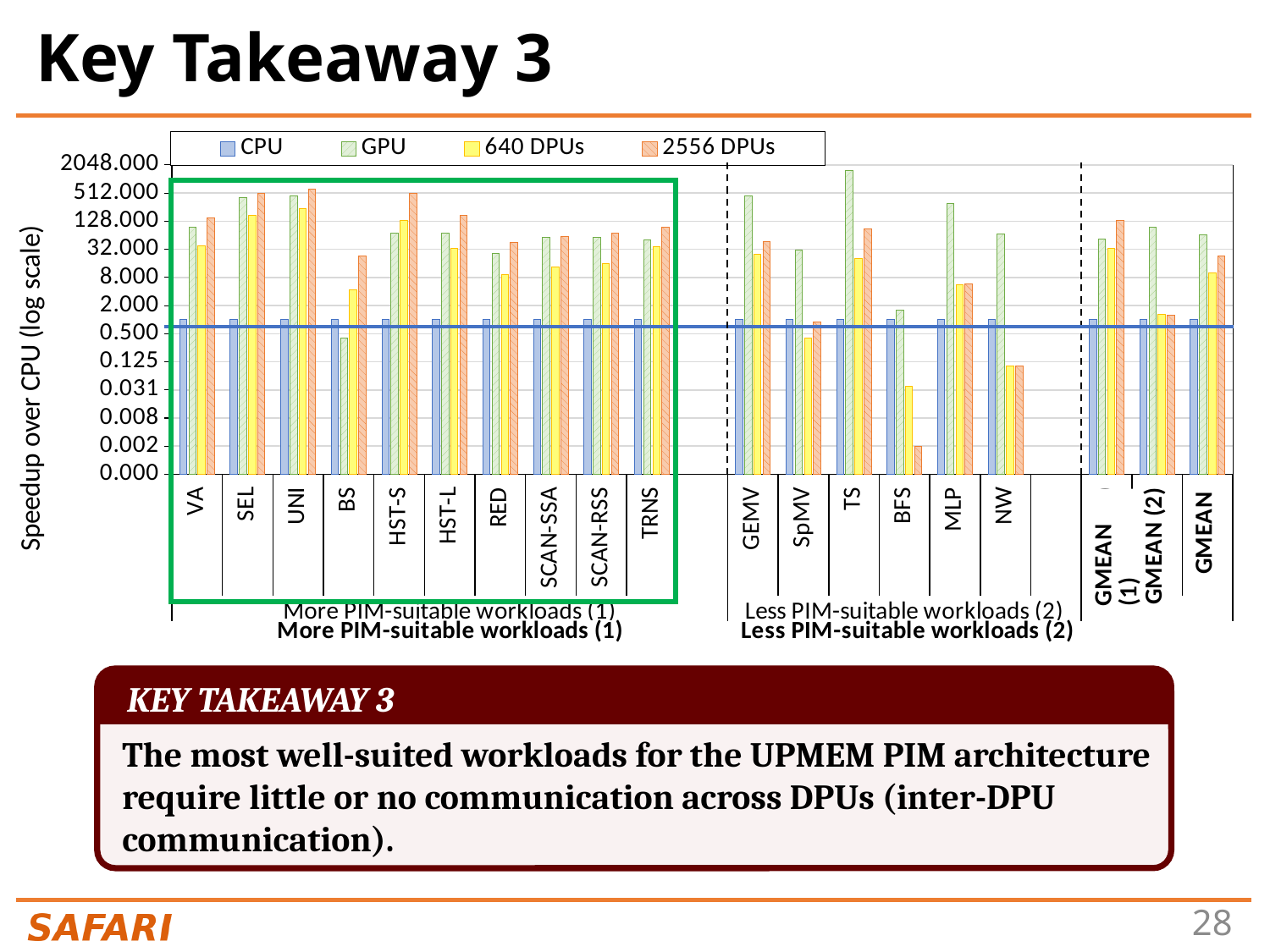
Is the 640 DPUs value for NW greater or less than 0.5? less Is the GPU value for GEMV greater or less than 128? greater What kind of chart is shown on the slide? bar chart For BFS, which is larger: the GPU value or the 640 DPUs value? GPU Which workload has the highest GPU speedup? TS Which series are listed in the legend? CPU, GPU, 640 DPUs, 2556 DPUs How many workloads are in the 'Less PIM-suitable workloads (2)' group? 6 How many workloads are in the 'More PIM-suitable workloads (1)' group? 10 How many series does the legend list? 4 Is the GPU value for TS greater or less than 512? greater What is the label of the y axis? Speedup over CPU (log scale)